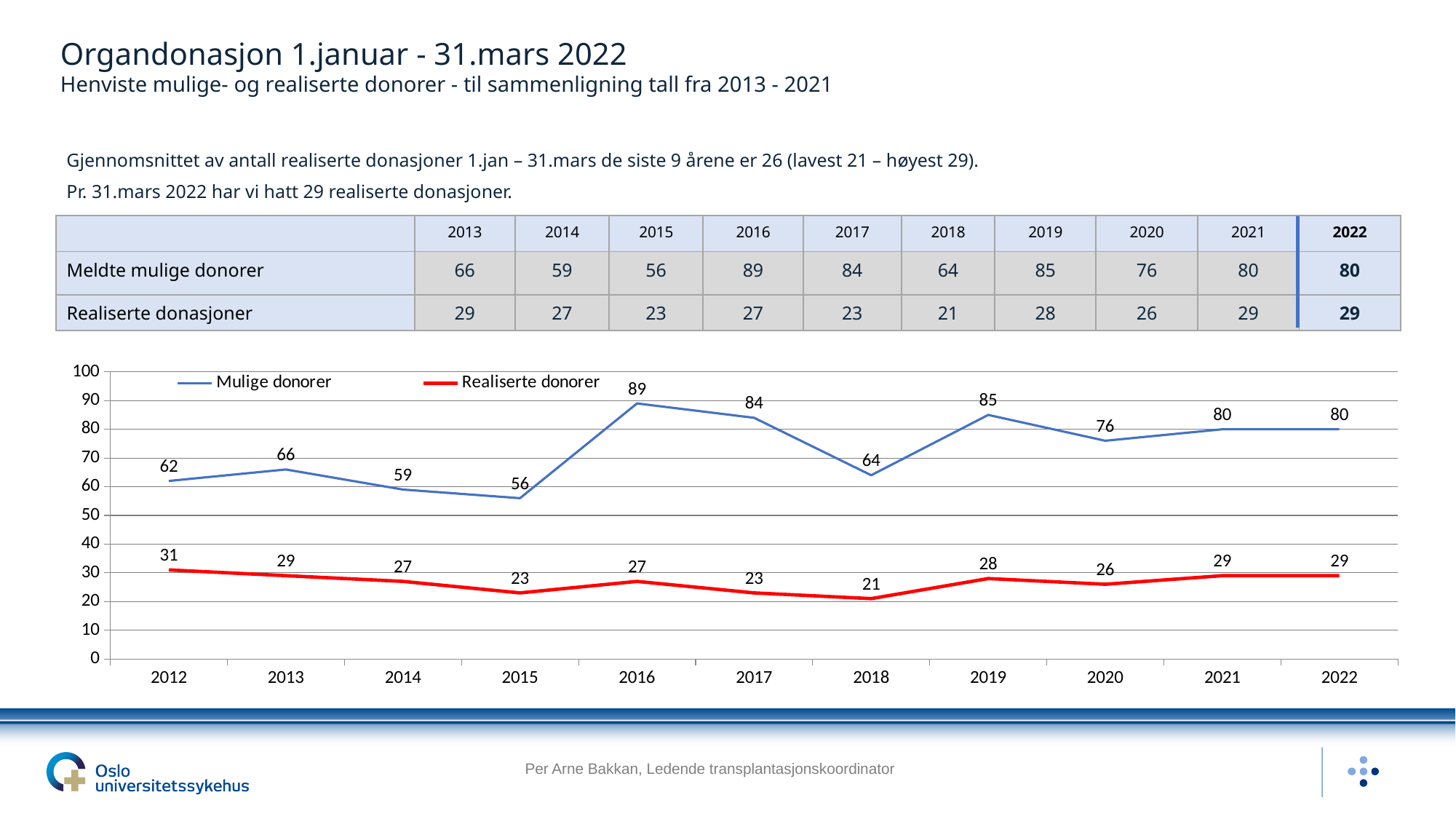
Is the value for Mulige donorer in 2015 greater or less than 60? less In which year is the Mulige donorer series highest? 2016 Which colour is used for the Realiserte donorer line? red What is the value for Realiserte donorer in 2018? 21 Does the Realiserte donorer series rise or fall from 2012 to 2015? fall How many years are plotted along the x axis of the chart? 11 How many series does the chart legend list? 2 What is the difference between Mulige donorer and Realiserte donorer in 2022? 51 Which is larger for Mulige donorer: the value in 2019 or the value in 2020? 2019 In which year is the Realiserte donorer series lowest? 2018 What is the value for Mulige donorer in 2016? 89 What kind of chart is shown on the slide? line chart